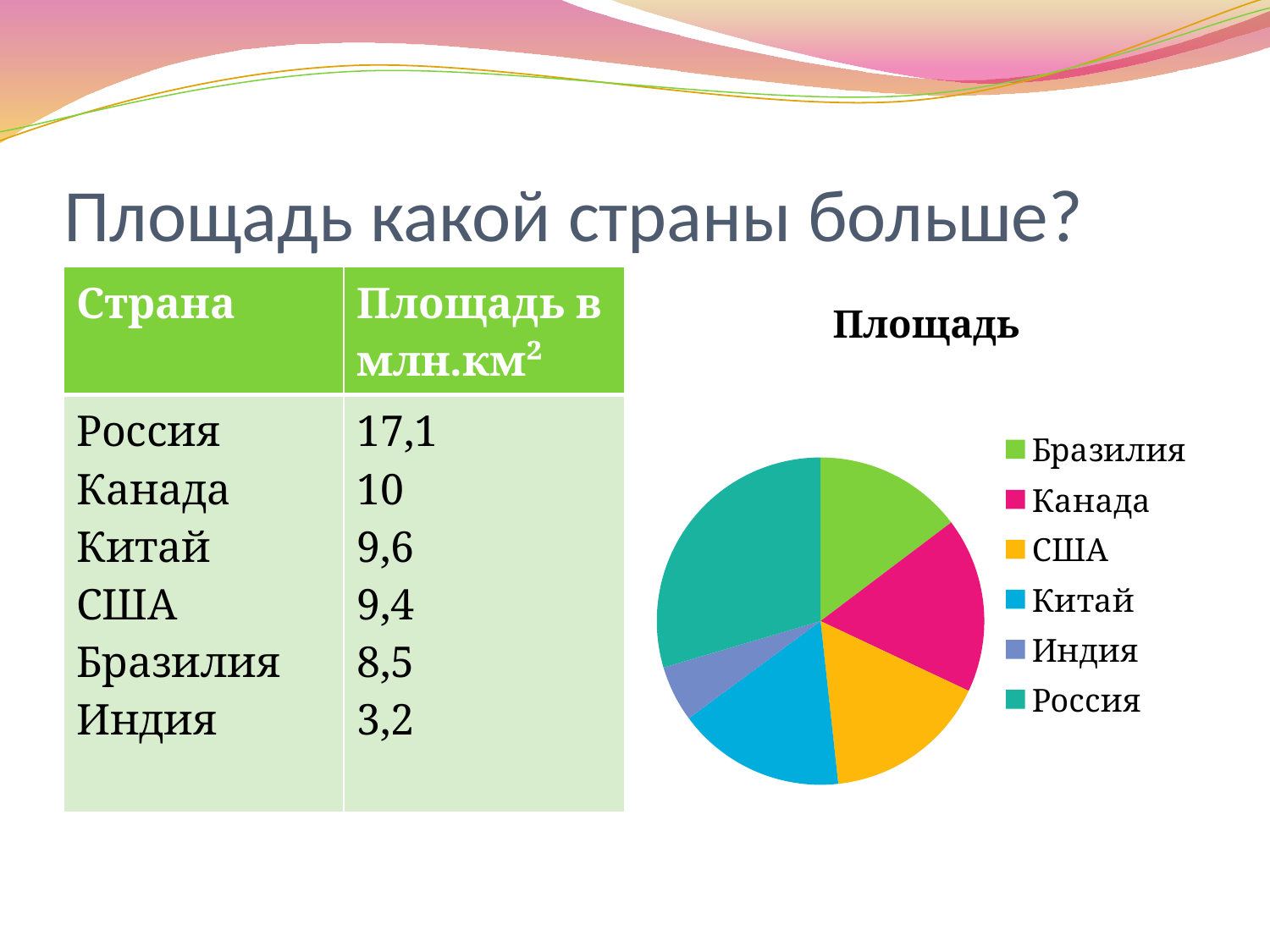
How many entries does the chart legend list? 6 What kind of chart is shown on the slide? pie chart How many slices does the pie chart have? 6 Which country has the largest slice in the pie chart? Россия What is the title of the chart? Площадь What is the area of Россия in млн.км² according to the slide? 17,1 What is the difference in area between Россия and Канада in млн.км²? 7,1 What colour is the slice for Россия in the pie chart? teal Which slice is larger, Россия or Бразилия? Россия What is the area of Индия in млн.км² according to the slide? 3,2 Which slice is larger, Канада or Индия? Канада Which country has the smallest slice in the pie chart? Индия